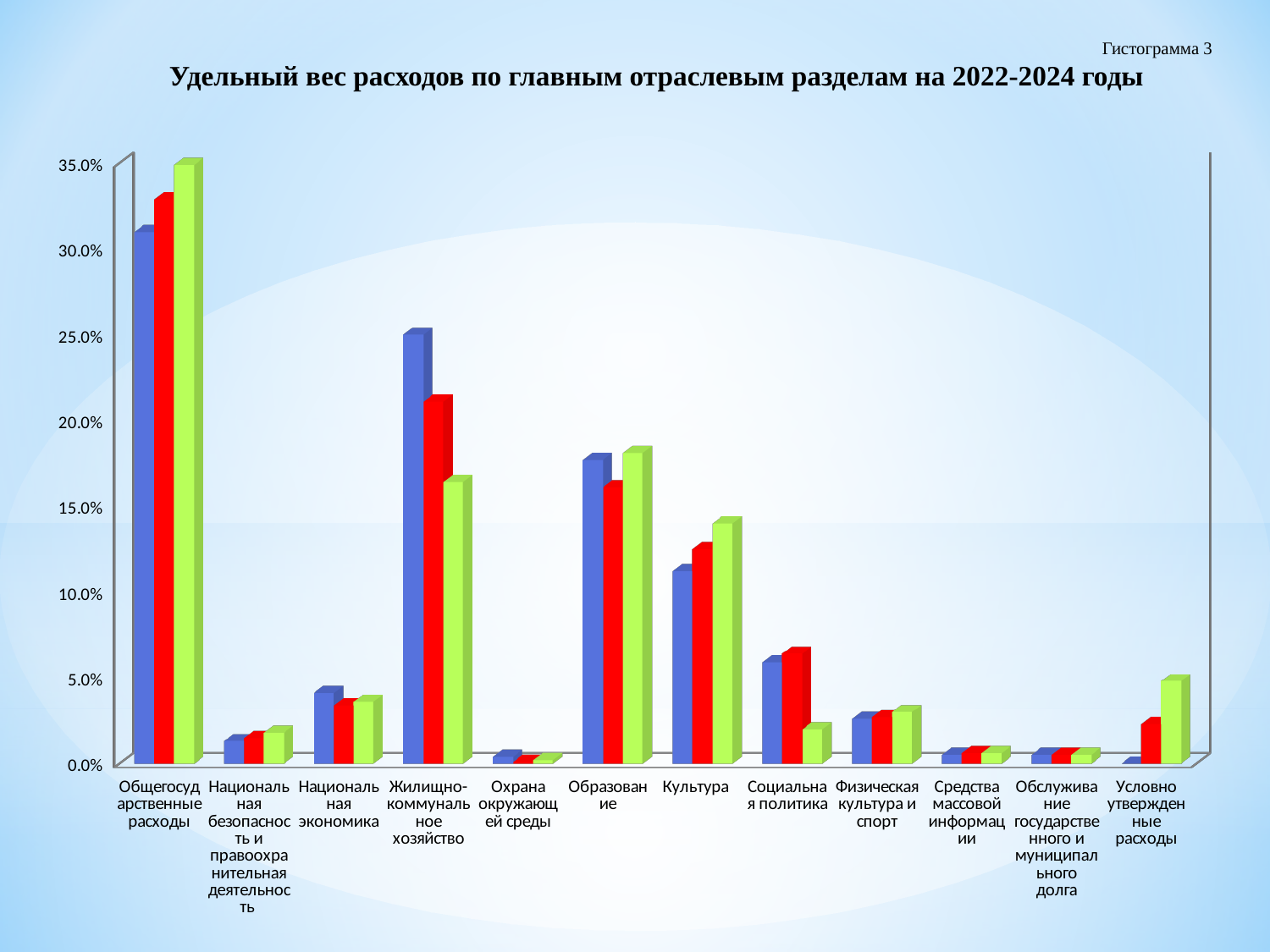
What is the title of the chart? Удельный вес расходов по главным отраслевым разделам на 2022-2024 годы Is the value of the blue bar for Образование greater or less than 20.0%? less Is the value of the red bar for Жилищно-коммунальное хозяйство greater or less than 20.0%? greater How many bars are plotted for each category in the chart? 3 Which category has the lowest bars in the chart? Охрана окружающей среды What kind of chart is shown on the slide? bar chart How many categories are shown along the x axis of the chart? 12 Is the value of the blue bar for Социальная политика greater or less than 5.0%? greater Do the three bars for Жилищно-коммунальное хозяйство rise or fall from left to right? fall Which category has the tallest bars in the chart? Общегосударственные расходы Which is larger: the blue bar for Жилищно-коммунальное хозяйство or the blue bar for Образование? Жилищно-коммунальное хозяйство